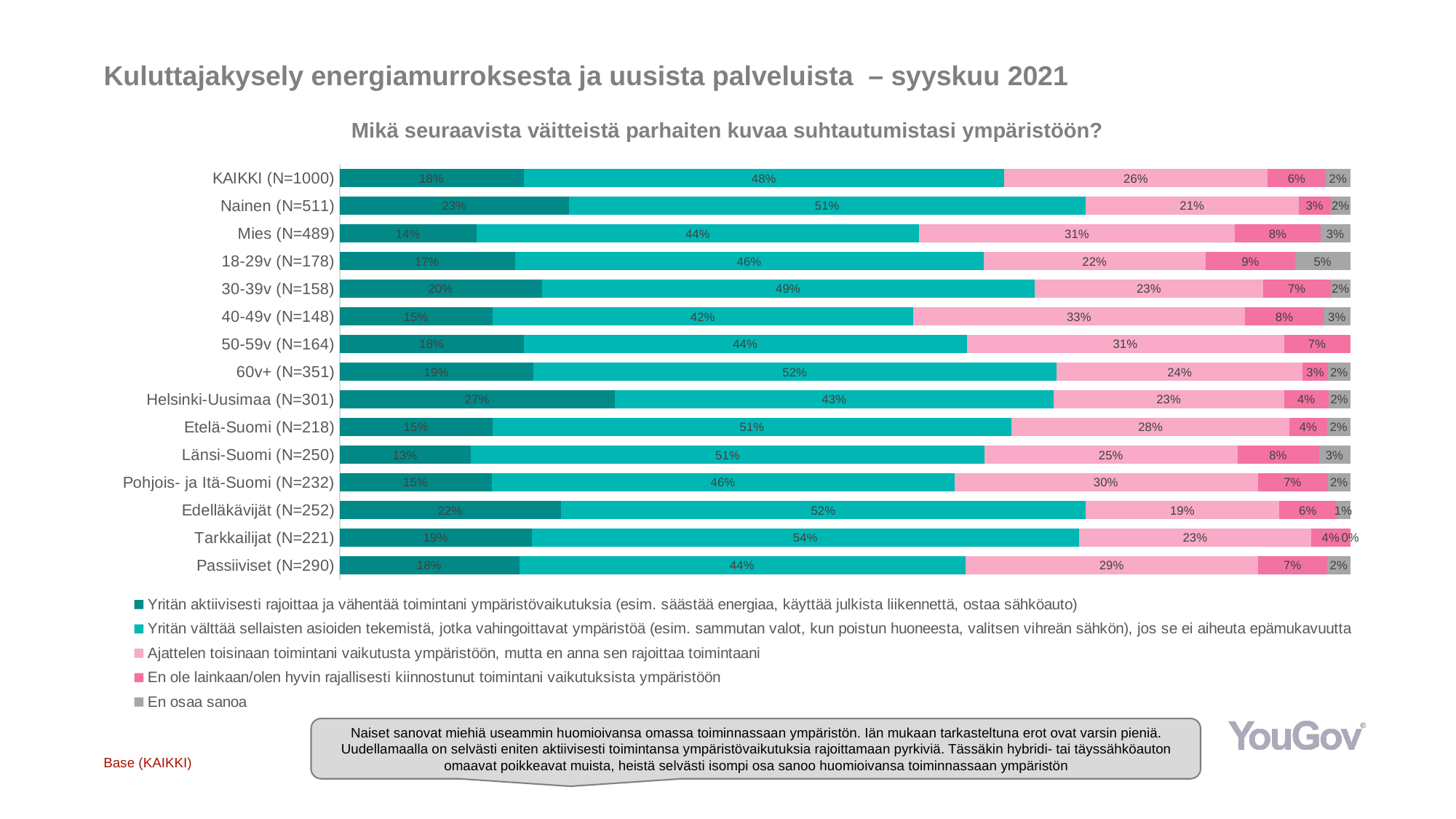
How many categories (respondent groups) are plotted on the chart? 15 Which is larger in the series 'En ole lainkaan/olen hyvin rajallisesti kiinnostunut toimintani vaikutuksista ympäristöön': 18-29v (N=178) or 60v+ (N=351)? 18-29v (N=178) What is the value for 40-49v (N=148) in the series 'Ajattelen toisinaan toimintani vaikutusta ympäristöön, mutta en anna sen rajoittaa toimintaani'? 33% What is the title of the chart? Mikä seuraavista väitteistä parhaiten kuvaa suhtautumistasi ympäristöön? What is the value for Nainen (N=511) in the series 'Yritän aktiivisesti rajoittaa ja vähentää toimintani ympäristövaikutuksia'? 23% What is the difference between Nainen (N=511) and Mies (N=489) in the series 'Yritän aktiivisesti rajoittaa ja vähentää toimintani ympäristövaikutuksia'? 9 percentage points How many series does the legend list? 5 What type of chart is shown on the slide? stacked bar chart Which category has the highest value in the series 'Yritän aktiivisesti rajoittaa ja vähentää toimintani ympäristövaikutuksia'? Helsinki-Uusimaa (N=301) Which category has the highest value in the 'En osaa sanoa' series? 18-29v (N=178) What is the value for Tarkkailijat (N=221) in the series 'Yritän välttää sellaisten asioiden tekemistä, jotka vahingoittavat ympäristöä'? 54% Which category has the lowest value in the series 'Yritän aktiivisesti rajoittaa ja vähentää toimintani ympäristövaikutuksia'? Länsi-Suomi (N=250)